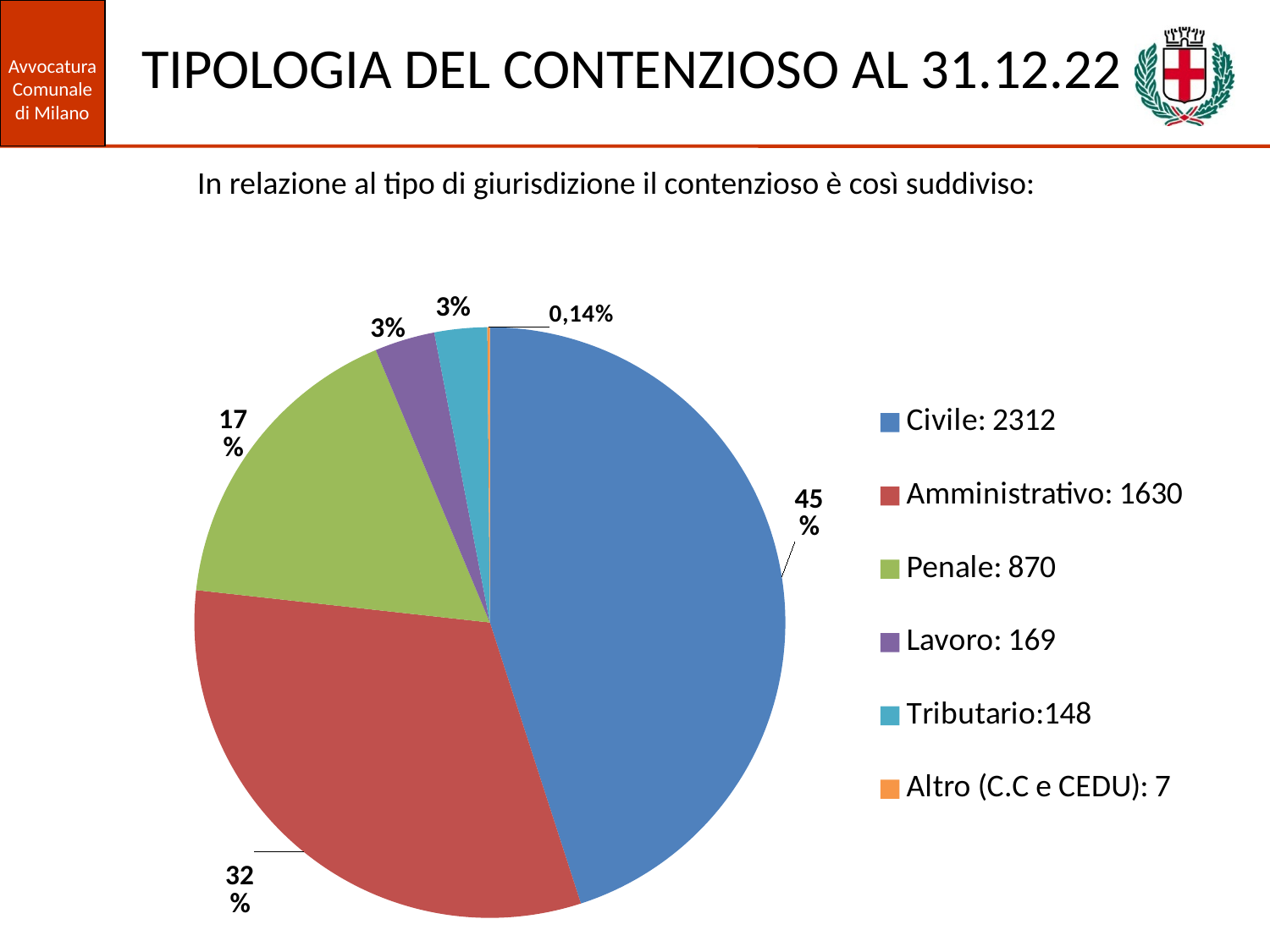
Which category has the smallest slice of the pie? Altro (C.C e CEDU) What is the value for Amministrativo shown in the legend? 1630 How many categories does the pie chart show? 6 What share of the pie does the Penale slice represent? 17% Which category has the largest slice of the pie? Civile What share of the pie does the Civile slice represent? 45% What colour is the Amministrativo slice in the pie chart? red What is the value for Civile shown in the legend? 2312 What is the value for Tributario shown in the legend? 148 What kind of chart is shown on the slide? pie chart What is the difference between the values for Civile and Amministrativo? 682 Which is larger, the value for Penale or the value for Lavoro? Penale